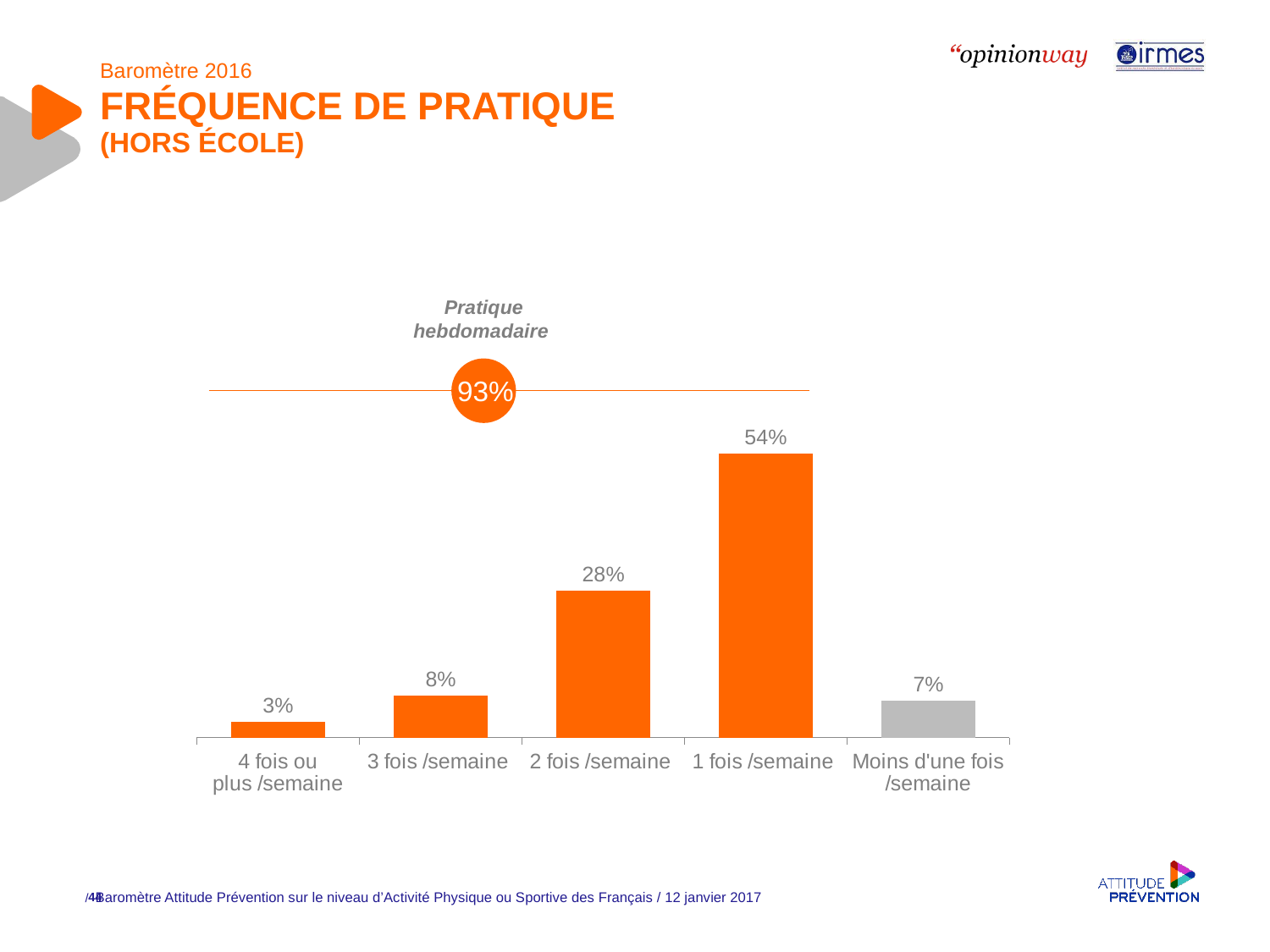
What kind of chart is shown on the slide? bar chart What percentage is shown in the orange circle labelled "Pratique hebdomadaire"? 93% What is the total of the values for "2 fois /semaine" and "3 fois /semaine"? 36% What is the value for "Moins d'une fois /semaine"? 7% Which category has the highest value? 1 fois /semaine How many categories are shown on the x axis? 5 Which category has the lowest value? 4 fois ou plus /semaine What is the difference between the values for "1 fois /semaine" and "2 fois /semaine"? 26% What is the value for "4 fois ou plus /semaine"? 3% Which bar is coloured grey rather than orange? Moins d'une fois /semaine What is the value for "1 fois /semaine"? 54% Which is larger, the value for "3 fois /semaine" or the value for "Moins d'une fois /semaine"? 3 fois /semaine